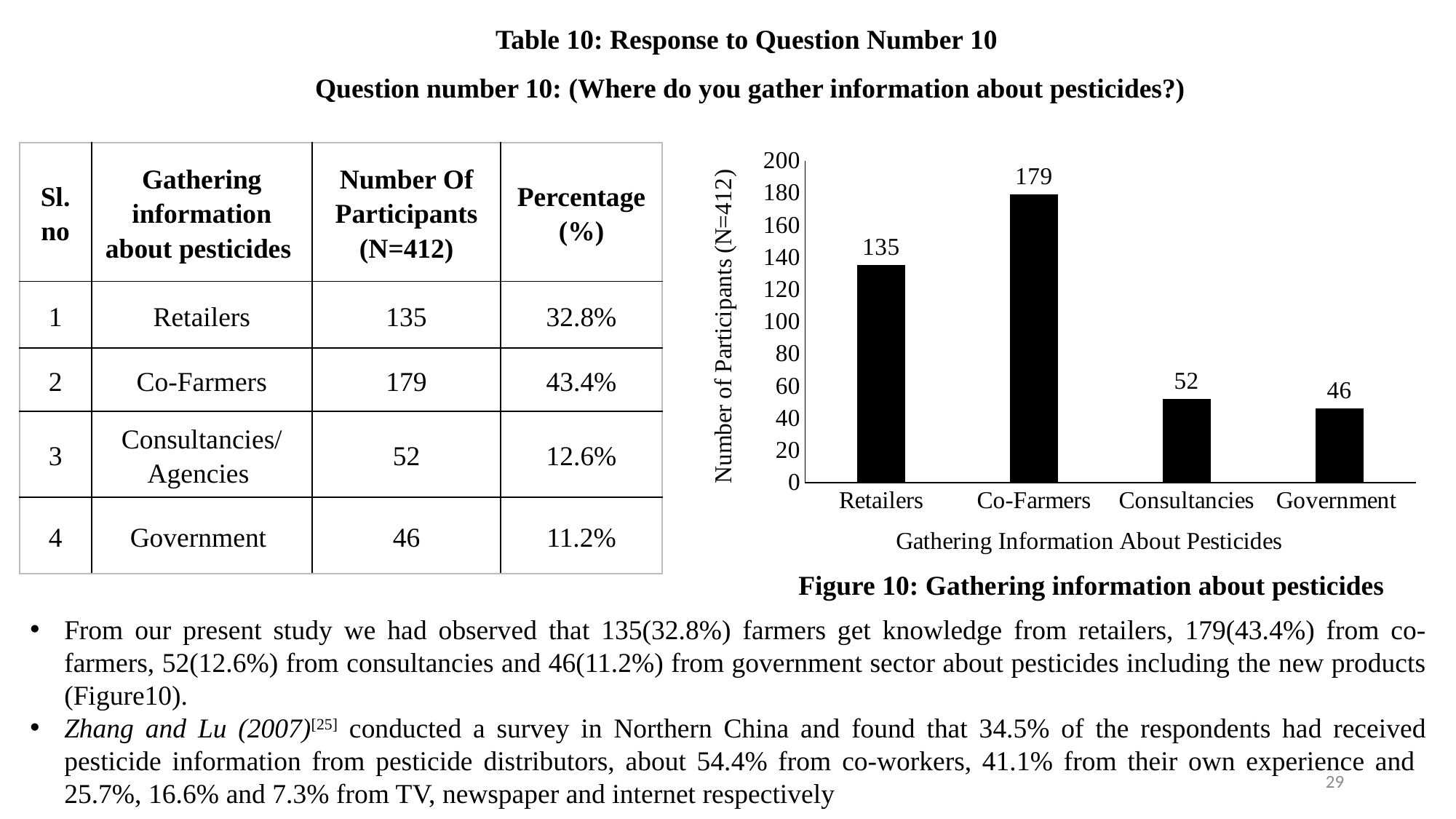
What is the label of the y axis of the chart? Number of Participants (N=412) Is the value for Co-Farmers greater or less than 160? greater What kind of chart is shown in Figure 10? bar chart What is the number of participants for Co-Farmers in the chart? 179 Which category has the highest number of participants in the chart? Co-Farmers How many categories are shown on the x axis of the chart? 4 What is the number of participants for Government in the chart? 46 What is the difference in number of participants between Consultancies and Government? 6 What is the difference in number of participants between Co-Farmers and Retailers? 44 What is the number of participants for Retailers in the chart? 135 Which has more participants, Retailers or Consultancies? Retailers Which category has the lowest number of participants in the chart? Government